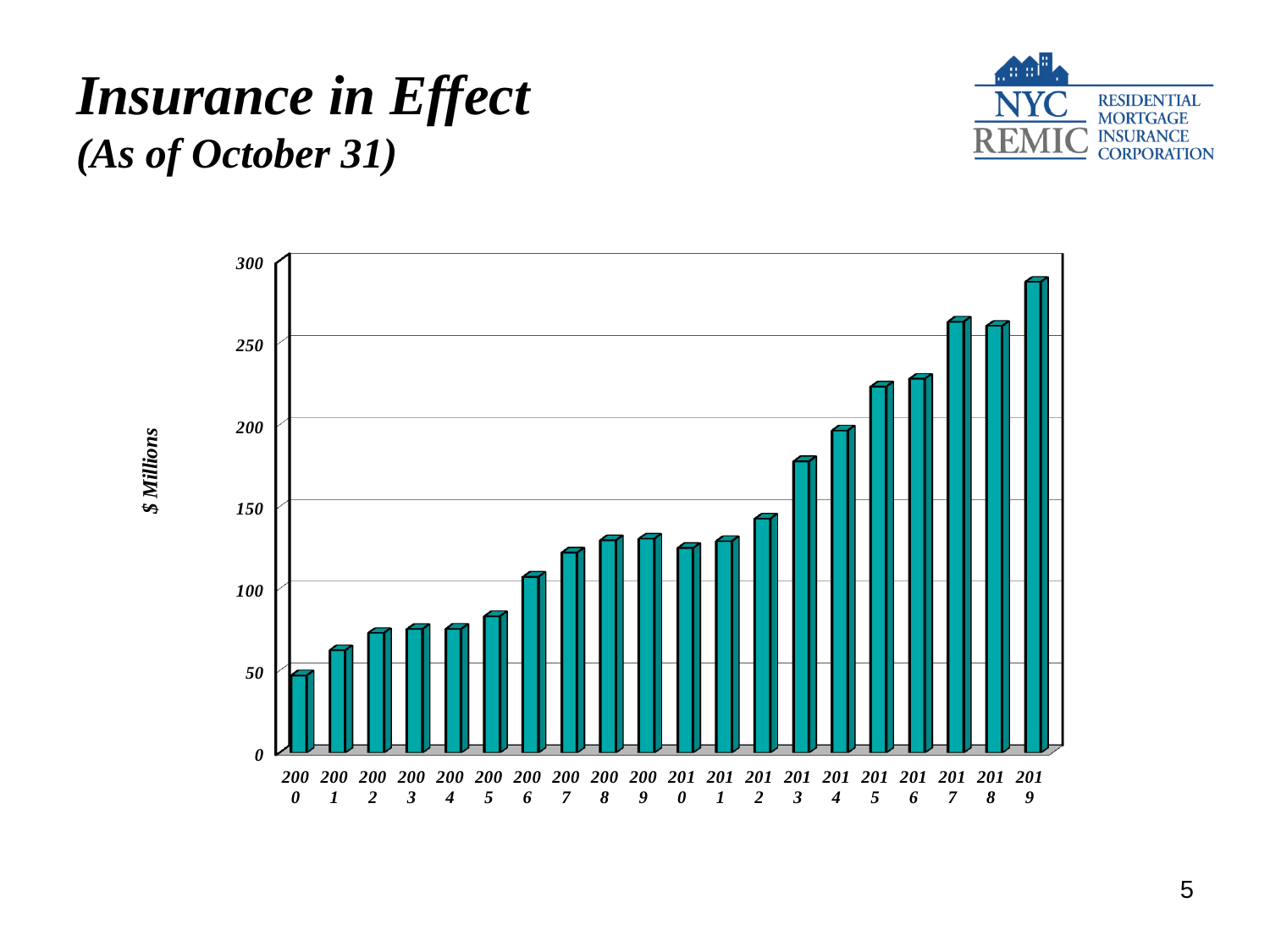
Is the value for 2019 greater or less than 250? greater Which year has the lowest insurance in effect? 2000 Which is larger, the value for 2013 or the value for 2010? 2013 What is the label on the vertical axis of the chart? $ Millions Overall, do the values rise or fall from 2000 to 2019? rise How many years (bars) are plotted on the chart? 20 What kind of chart is shown on the slide? bar chart Which is larger, the value for 2005 or the value for 2007? 2007 Which year has the highest insurance in effect? 2019 Is the value for 2006 greater or less than 100? greater